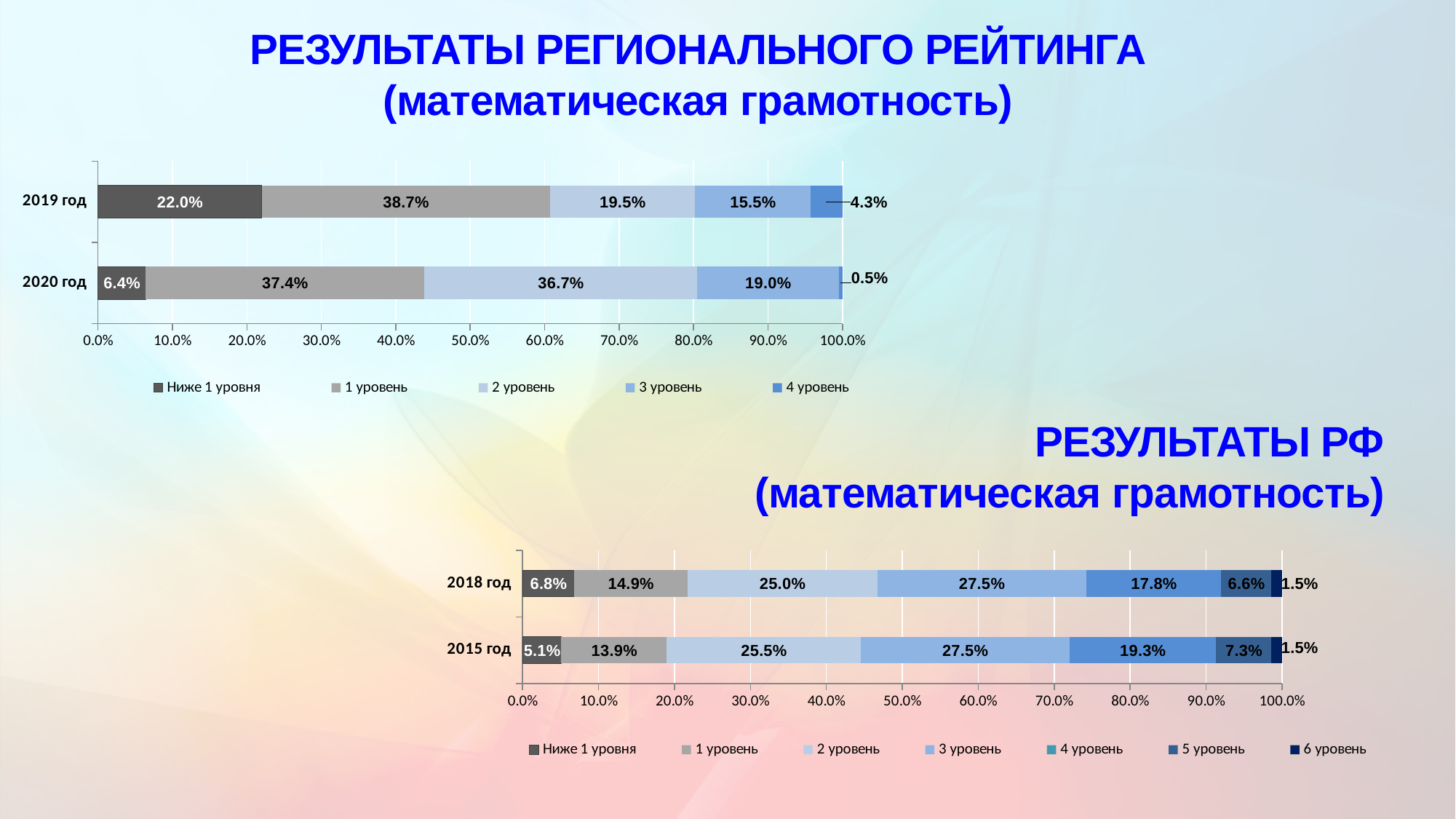
In the bottom chart (РЕЗУЛЬТАТЫ РФ), what is the difference between '4 уровень' in 2015 год and in 2018 год? 1.5 percentage points In the bottom chart (РЕЗУЛЬТАТЫ РФ), what is the value for '3 уровень' in 2018 год? 27.5% In the bottom chart (РЕЗУЛЬТАТЫ РФ), what is the value for '5 уровень' in 2015 год? 7.3% In the top chart (РЕЗУЛЬТАТЫ РЕГИОНАЛЬНОГО РЕЙТИНГА), by how many percentage points did 'Ниже 1 уровня' change from 2019 год to 2020 год? 15.6 percentage points lower in 2020 How many series does the legend of the bottom chart (РЕЗУЛЬТАТЫ РФ) list? 7 In the top chart (РЕЗУЛЬТАТЫ РЕГИОНАЛЬНОГО РЕЙТИНГА), which year has the larger value for '3 уровень', 2019 год or 2020 год? 2020 год How many series does the legend of the top chart (РЕЗУЛЬТАТЫ РЕГИОНАЛЬНОГО РЕЙТИНГА) list? 5 In the top chart (РЕЗУЛЬТАТЫ РЕГИОНАЛЬНОГО РЕЙТИНГА), what is the value for 'Ниже 1 уровня' in 2019 год? 22.0% In the top chart (РЕЗУЛЬТАТЫ РЕГИОНАЛЬНОГО РЕЙТИНГА), what is the value for '2 уровень' in 2020 год? 36.7% In the bottom chart (РЕЗУЛЬТАТЫ РФ), which segment is the largest in the 2015 год bar? 3 уровень (27.5%) What type of chart is the bottom chart (РЕЗУЛЬТАТЫ РФ)? Stacked horizontal bar chart In the top chart (РЕЗУЛЬТАТЫ РЕГИОНАЛЬНОГО РЕЙТИНГА), what is the value for '4 уровень' in 2019 год? 4.3%